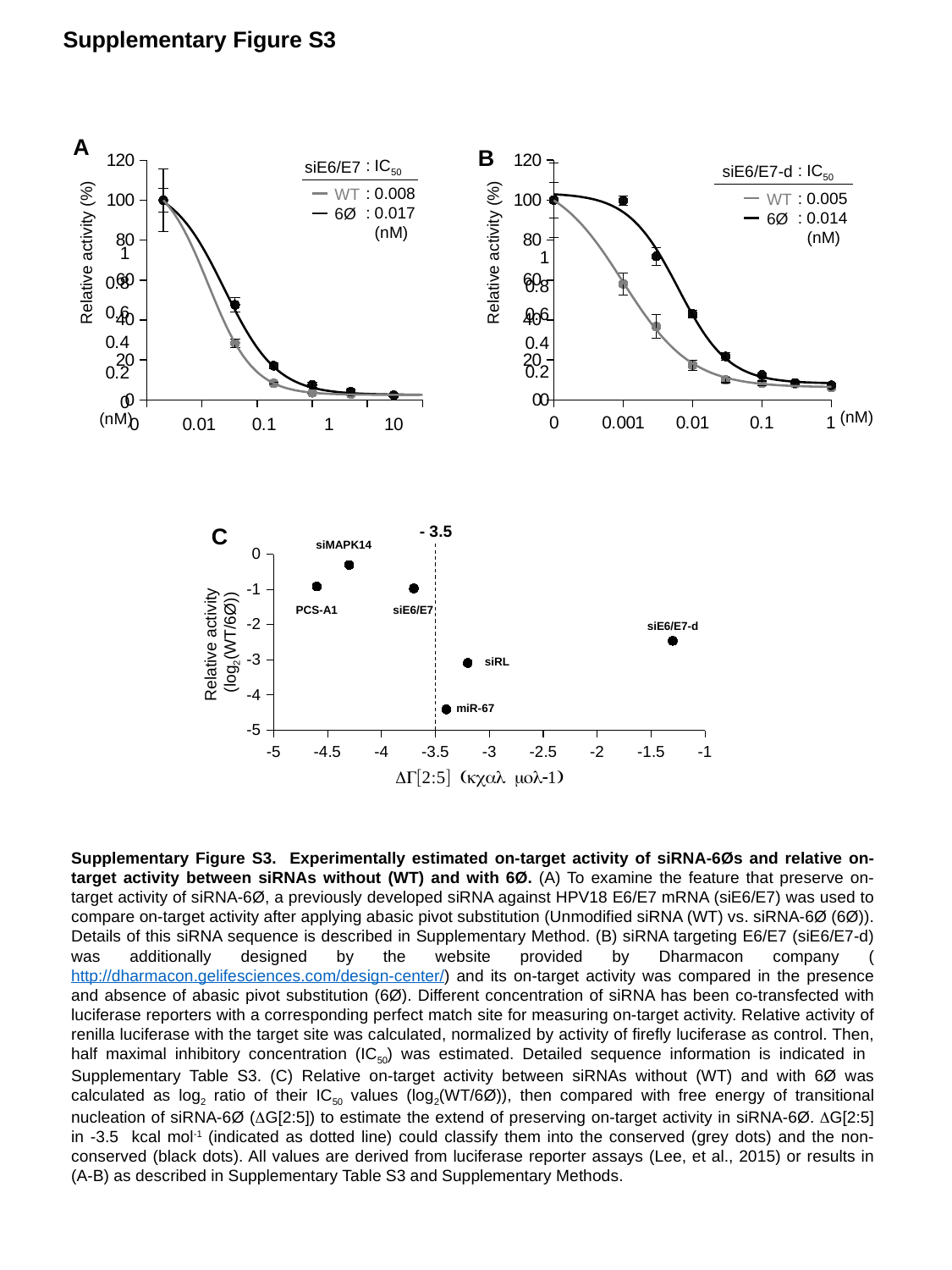
What kind of chart is chart A (siE6/E7)? Line chart How many series does the legend of chart A (siE6/E7) list? 2 In chart B (siE6/E7-d), what is the IC50 value listed for 6Ø? 0.014 In chart B (siE6/E7-d), what is the difference between the 6Ø and WT IC50 values? 0.009 In chart B (siE6/E7-d), does relative activity rise or fall as the concentration increases along the x axis? Fall In chart B (siE6/E7-d), what is the IC50 value listed for WT? 0.005 In chart A (siE6/E7), what is the IC50 value listed for 6Ø? 0.017 In chart A (siE6/E7), which has the larger IC50 value, WT or 6Ø? 6Ø In chart C, which labeled point has the lowest relative activity (log2(WT/6Ø))? miR-67 In chart C, is the relative activity value for miR-67 greater or less than -4? less How many labeled data points are plotted in chart C? 6 In chart A (siE6/E7), what is the IC50 value listed for WT? 0.008